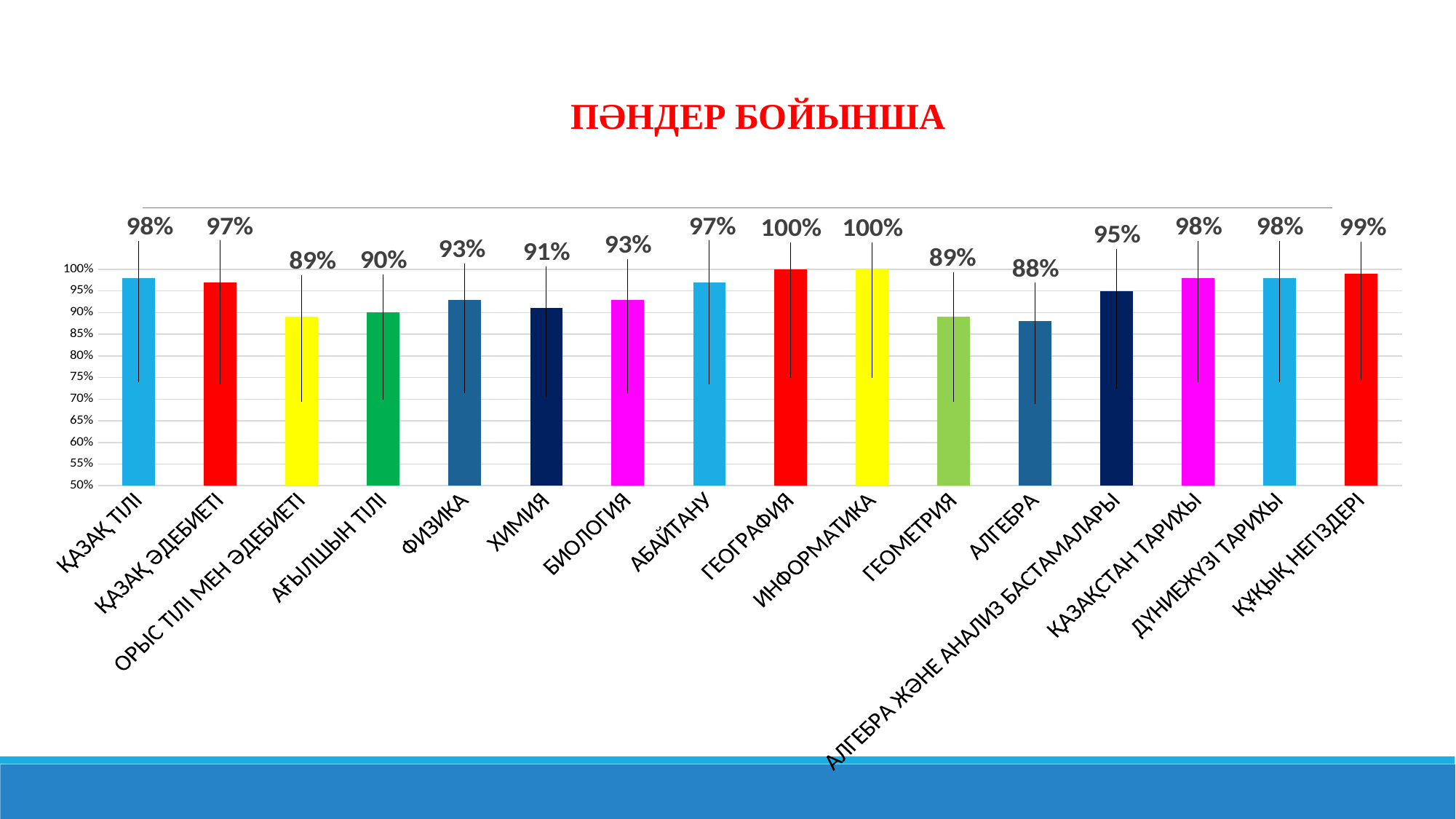
What is the value for АЛГЕБРА ЖӘНЕ АНАЛИЗ БАСТАМАЛАРЫ? 95% Which category has the lowest value? АЛГЕБРА Which is larger, the value for ФИЗИКА or the value for АҒЫЛШЫН ТІЛІ? ФИЗИКА What is the difference between the values for ГЕОГРАФИЯ and АЛГЕБРА? 12% What is the value for ХИМИЯ? 91% What kind of chart is shown on the slide? Bar chart What is the value for ҚҰҚЫҚ НЕГІЗДЕРІ? 99% What is the difference between the values for ҚАЗАҚ ТІЛІ and ОРЫС ТІЛІ МЕН ӘДЕБИЕТІ? 9% How many categories are shown in the chart? 16 Which categories have the highest value of 100%? ГЕОГРАФИЯ and ИНФОРМАТИКА What is the title of the slide? ПӘНДЕР БОЙЫНША What is the value for ҚАЗАҚ ТІЛІ? 98%